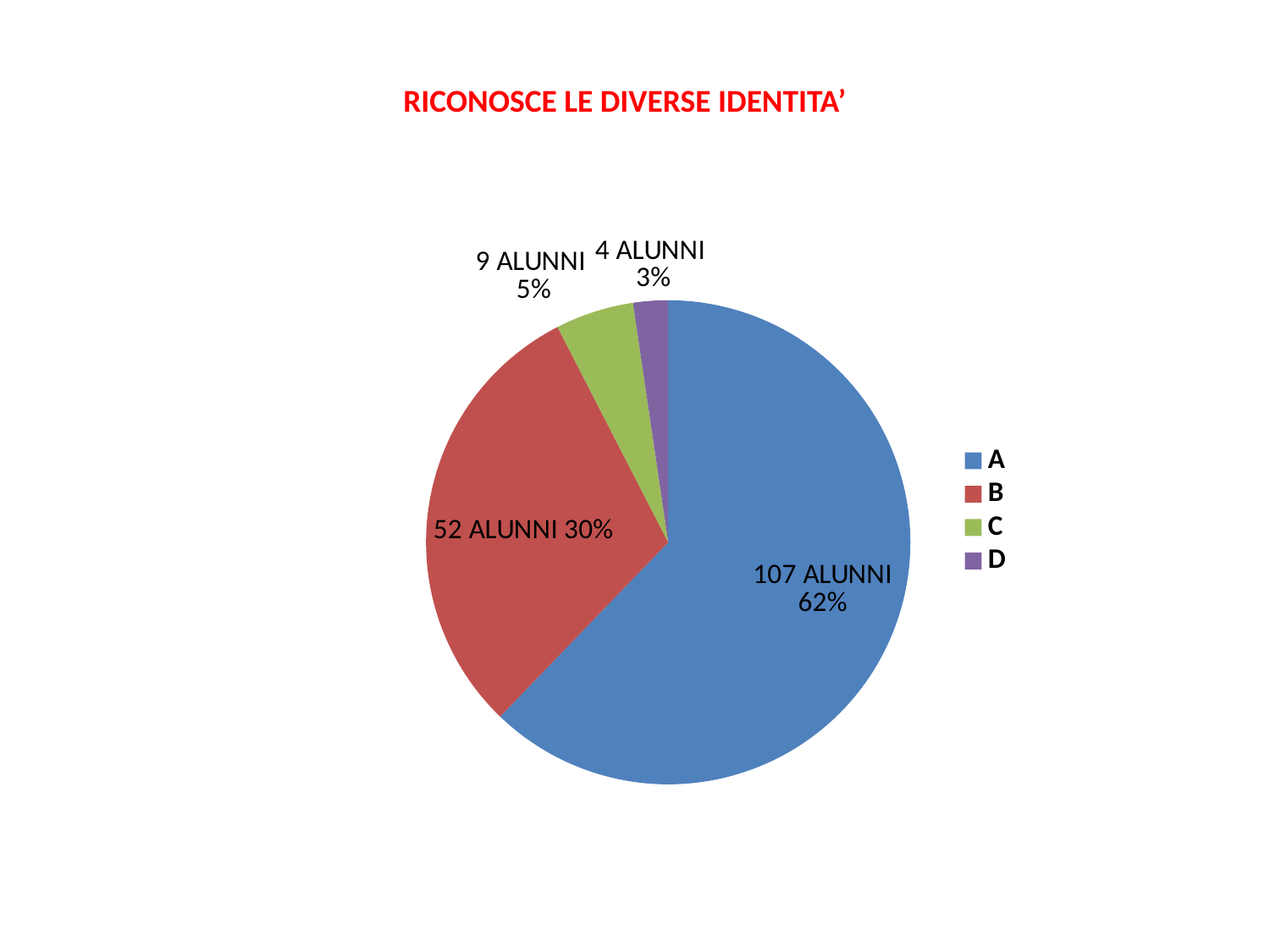
Which category has the smallest slice? D How many alunni are in category C? 9 ALUNNI What is the title of the chart? RICONOSCE LE DIVERSE IDENTITA' Which is larger, the slice for B or the slice for C? B What percentage share does slice B have? 30% Which category has the largest slice? A What percentage share does slice A have? 62% How many slices does the pie chart have? 4 What kind of chart is shown on the slide? pie chart What is the difference in number of alunni between category A and category B? 55 How many alunni are in category D? 4 ALUNNI How many entries does the legend list? 4